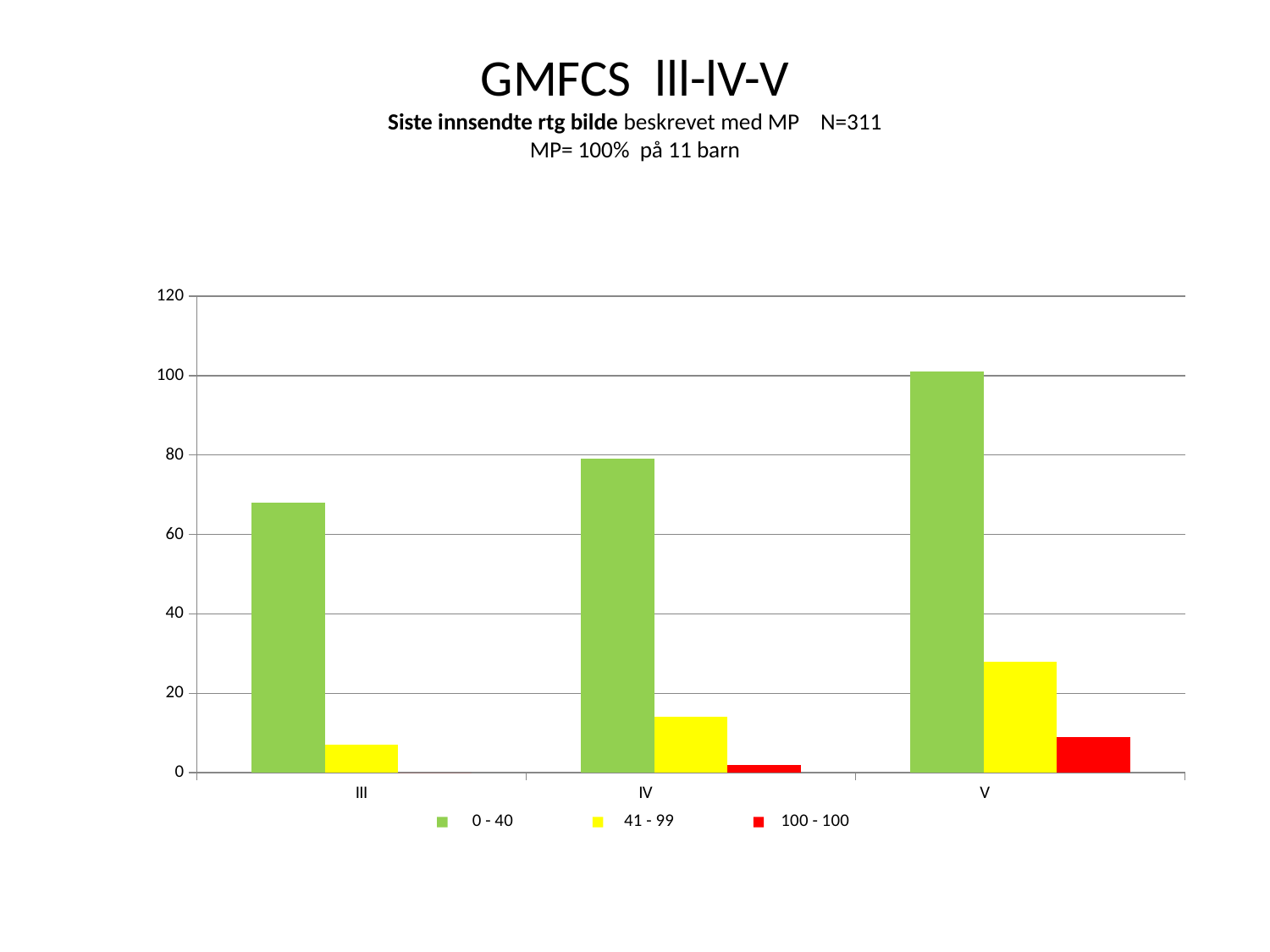
How many categories are shown on the x axis? 3 Which category has the lowest value for the 0 - 40 series? III Which is larger: the 0 - 40 value for IV or the 0 - 40 value for III? IV How many series does the legend list? 3 Is the value for the 0 - 40 series in category III greater or less than 60? greater What kind of chart is shown on the slide? bar chart Is the value for the 100 - 100 series in category V greater or less than 20? less Is the value for the 41 - 99 series in category V greater or less than 20? greater Do the values of the 0 - 40 series rise or fall from III to V? rise Which category has the highest value for the 0 - 40 series? V Which category has the highest value for the 41 - 99 series? V